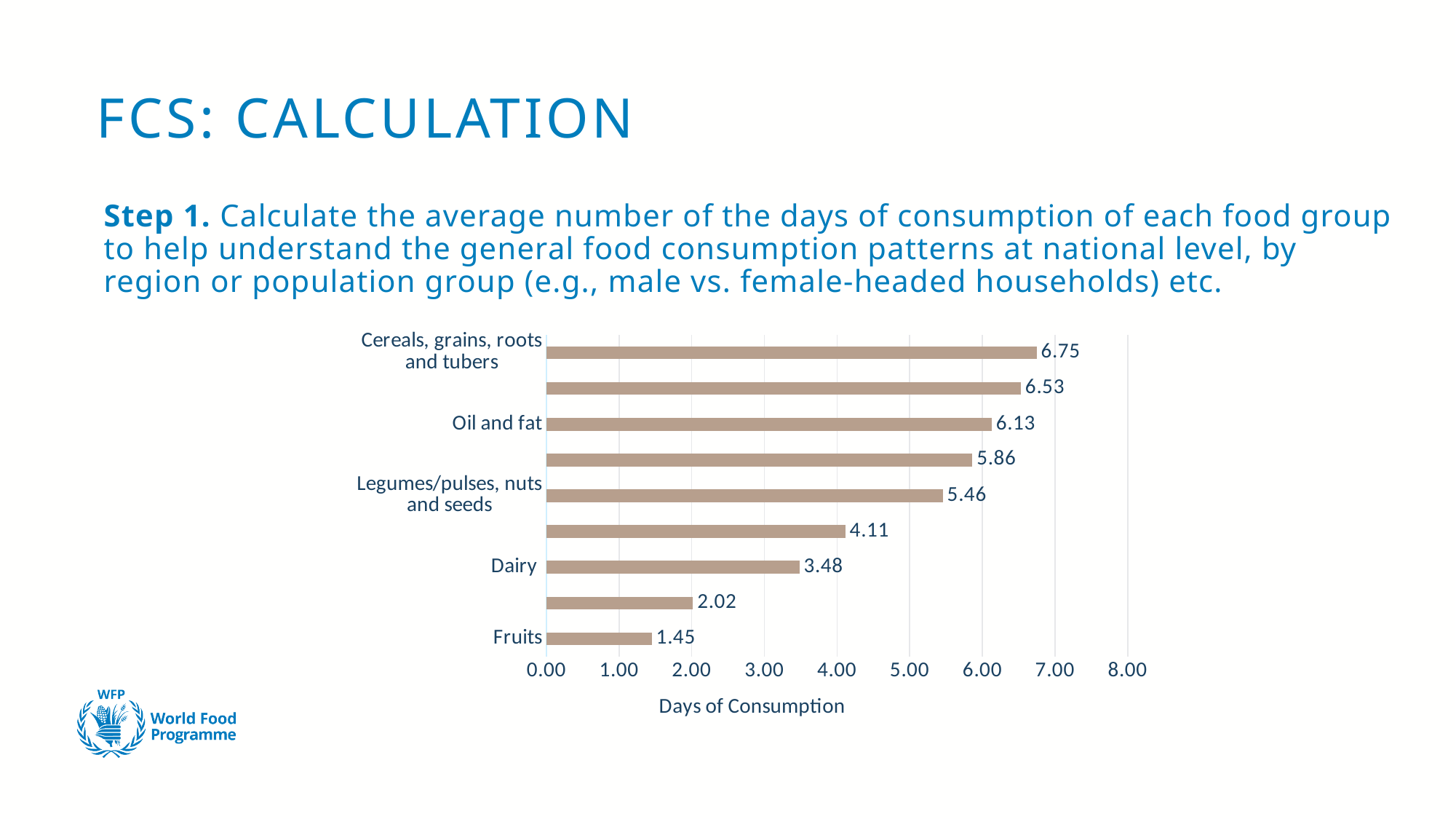
Which is larger, the value for Dairy or the value for Fruits? Dairy What is the value for Fruits? 1.45 What is the difference between the values for Oil and fat and Dairy? 2.65 What is the label of the horizontal axis? Days of Consumption Which labelled category has the lowest value? Fruits What is the value for Oil and fat? 6.13 What is the value for Cereals, grains, roots and tubers? 6.75 What is the value for Dairy? 3.48 How many bars are plotted in the chart? 9 What is the value for Legumes/pulses, nuts and seeds? 5.46 Which labelled category has the highest value? Cereals, grains, roots and tubers What kind of chart is shown on the slide? Bar chart